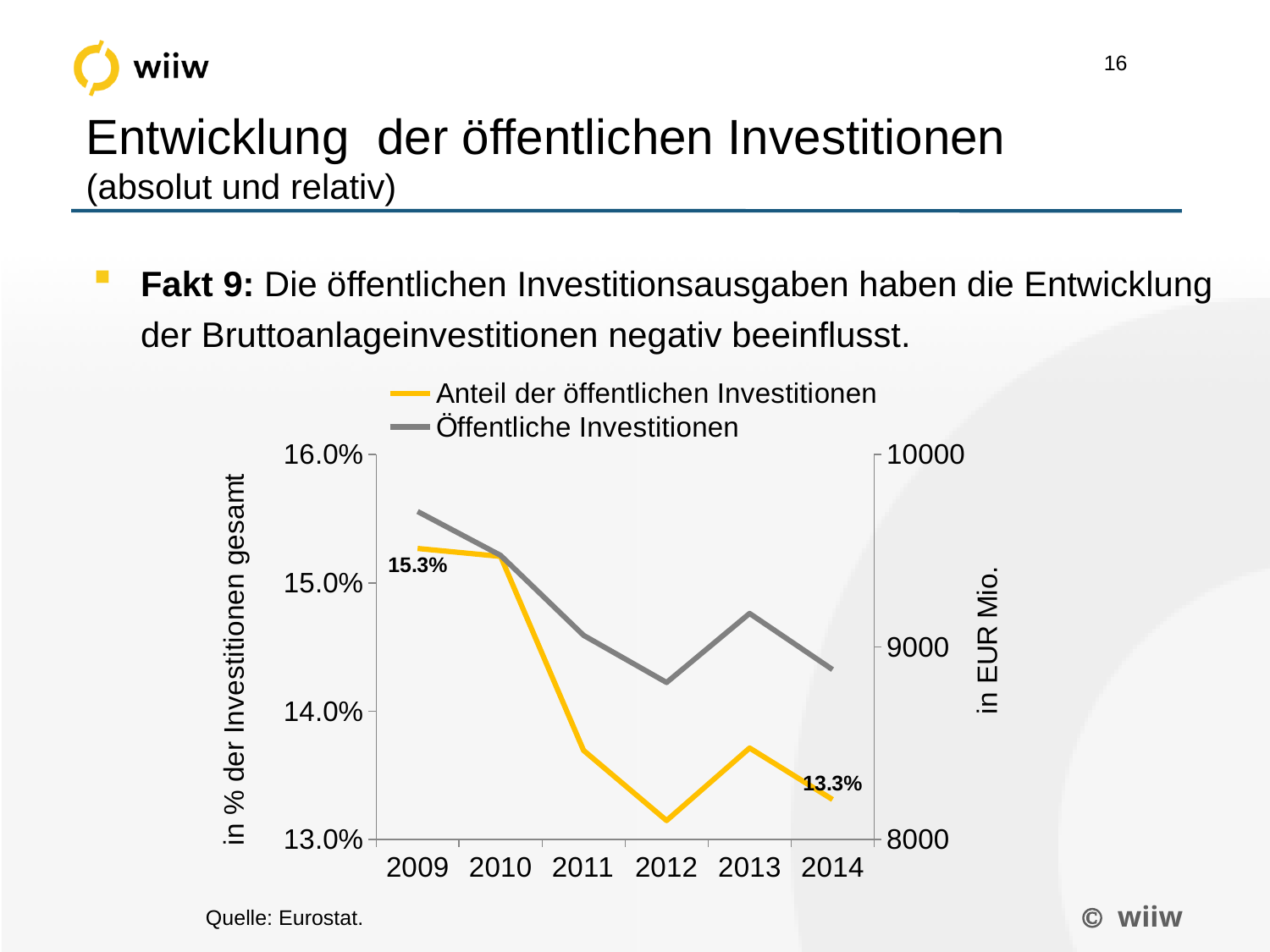
How many years are shown on the x axis? 6 How many series does the legend list? 2 In which year is 'Öffentliche Investitionen' highest? 2009 What is the value of 'Anteil der öffentlichen Investitionen' in 2014? 13.3% What is the value of 'Anteil der öffentlichen Investitionen' in 2009? 15.3% Does 'Anteil der öffentlichen Investitionen' rise or fall overall from 2009 to 2014? Fall What kind of chart is shown on the slide? Line chart What unit is shown on the right-hand axis? in EUR Mio. Which year has the larger value for 'Anteil der öffentlichen Investitionen', 2012 or 2013? 2013 By how many percentage points did 'Anteil der öffentlichen Investitionen' fall from 2009 to 2014? 2.0 percentage points In which year is 'Anteil der öffentlichen Investitionen' lowest? 2012 Is the value for 'Öffentliche Investitionen' in 2012 greater or less than 9000? less